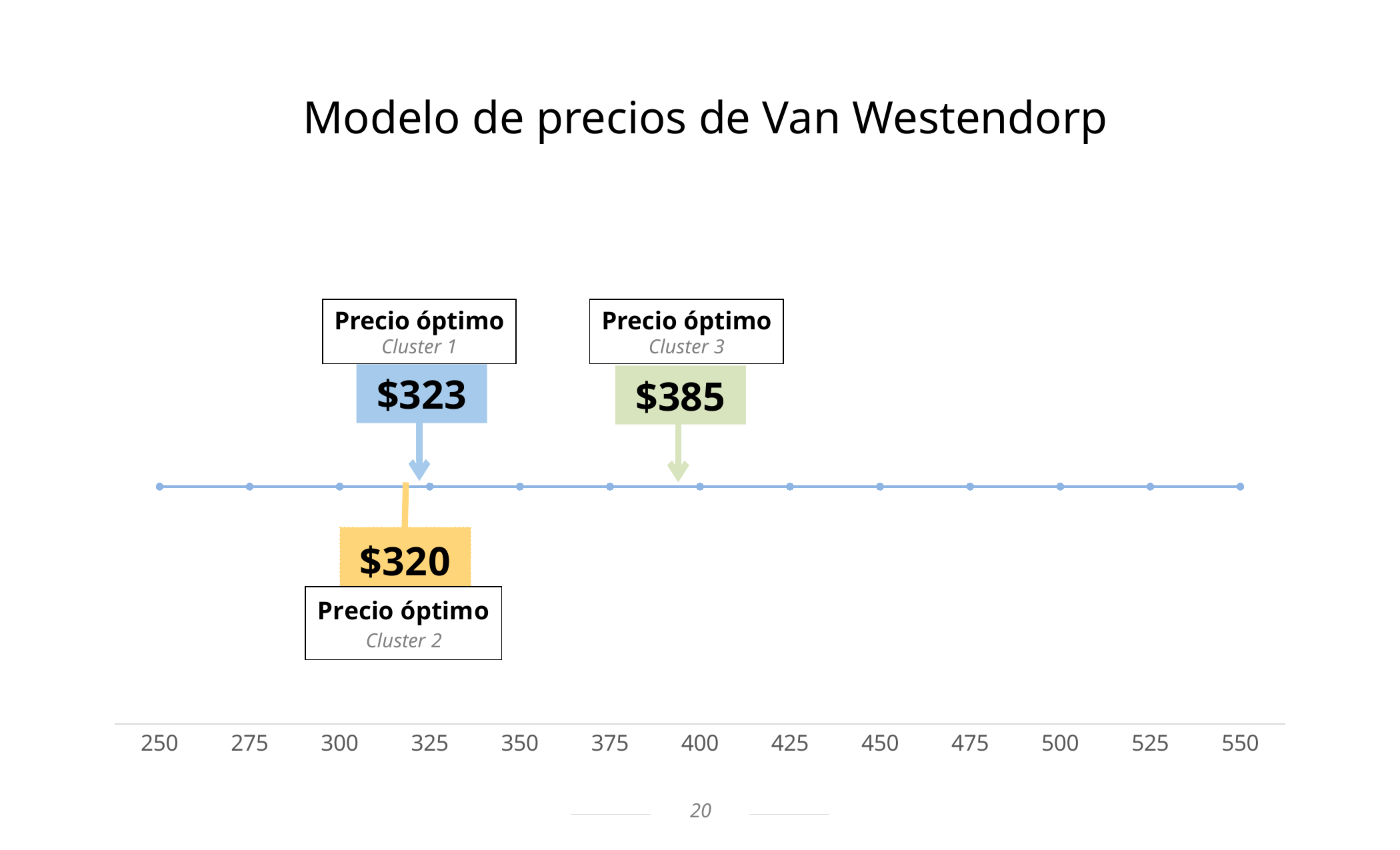
What is the title of the chart? Modelo de precios de Van Westendorp What is the difference between the optimal prices of Cluster 3 and Cluster 1? $62 What is the difference between the optimal prices of Cluster 1 and Cluster 2? $3 Which is larger, the optimal price for Cluster 1 or for Cluster 2? Cluster 1 Which cluster has the highest optimal price? Cluster 3 Which cluster has the lowest optimal price? Cluster 2 What is the optimal price (Precio óptimo) for Cluster 3? $385 What is the optimal price (Precio óptimo) for Cluster 1? $323 How many clusters have an optimal price marked on the chart? 3 What is the lowest value shown on the price axis? 250 Is the optimal price for Cluster 3 greater or less than 400? less What is the optimal price (Precio óptimo) for Cluster 2? $320